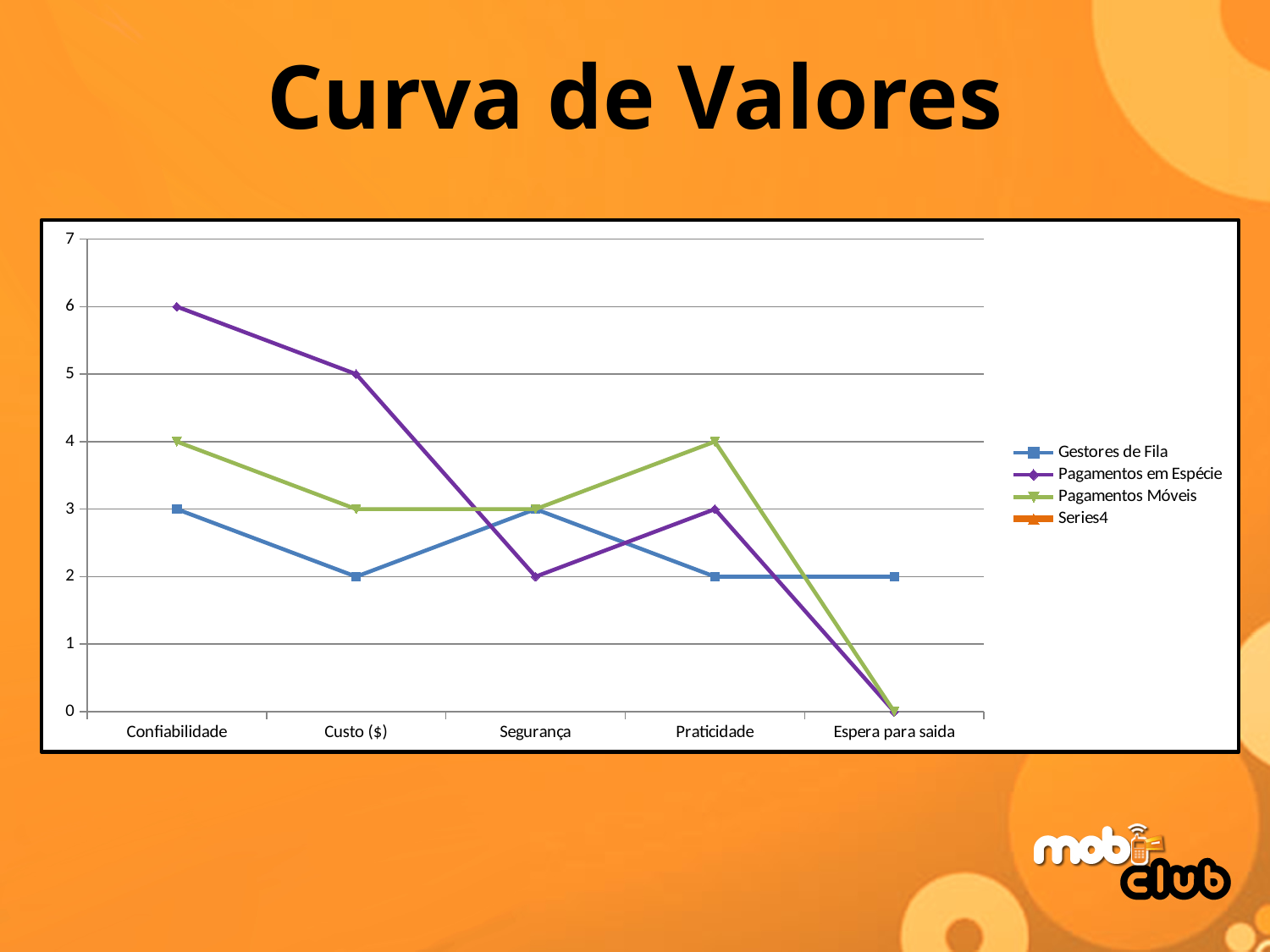
Does the Pagamentos em Espécie series rise or fall from Confiabilidade to Segurança? fall What is the value of Pagamentos Móveis for Praticidade? 4 How many categories are shown on the x axis? 5 What type of chart is shown on the slide? line chart What is the difference between Pagamentos em Espécie and Gestores de Fila for Confiabilidade? 3 How many series does the legend list? 4 Which category has the highest value for Pagamentos em Espécie? Confiabilidade What is the title of the slide? Curva de Valores Which series has the larger value for Segurança, Gestores de Fila or Pagamentos em Espécie? Gestores de Fila Which category has the lowest value for Pagamentos Móveis? Espera para saida What is the value of Pagamentos em Espécie for Confiabilidade? 6 What is the value of Gestores de Fila for Custo ($)? 2